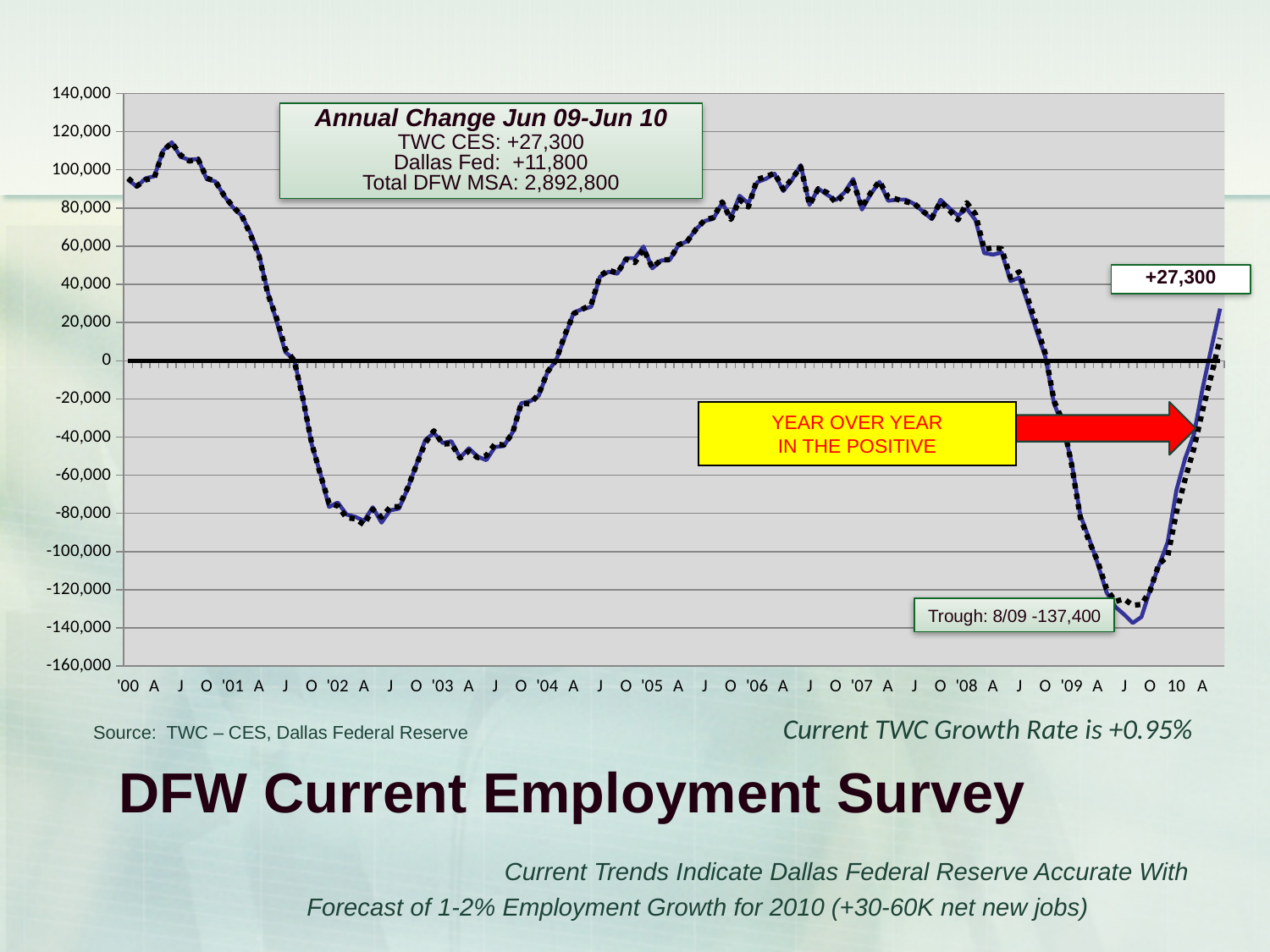
According to the annotation box, what is the Total DFW MSA figure? 2,892,800 What kind of chart is shown on the slide? line chart Is the value at '03 greater or less than -20,000? less According to the annotation box, what is the Dallas Fed annual change for Jun 09-Jun 10? +11,800 How much larger is the TWC CES annual change than the Dallas Fed annual change in the annotation box? 15,500 What is the trough value marked on the chart? -137,400 Which is larger, the value at '06 or the value at '03? '06 Is the value at '06 greater or less than 80,000? greater In which month/year does the chart mark the trough? 8/09 What source is cited below the chart? TWC – CES, Dallas Federal Reserve What value is labeled at the end of the line for Jun 10? +27,300 Do the values rise or fall between '00 and '02? fall